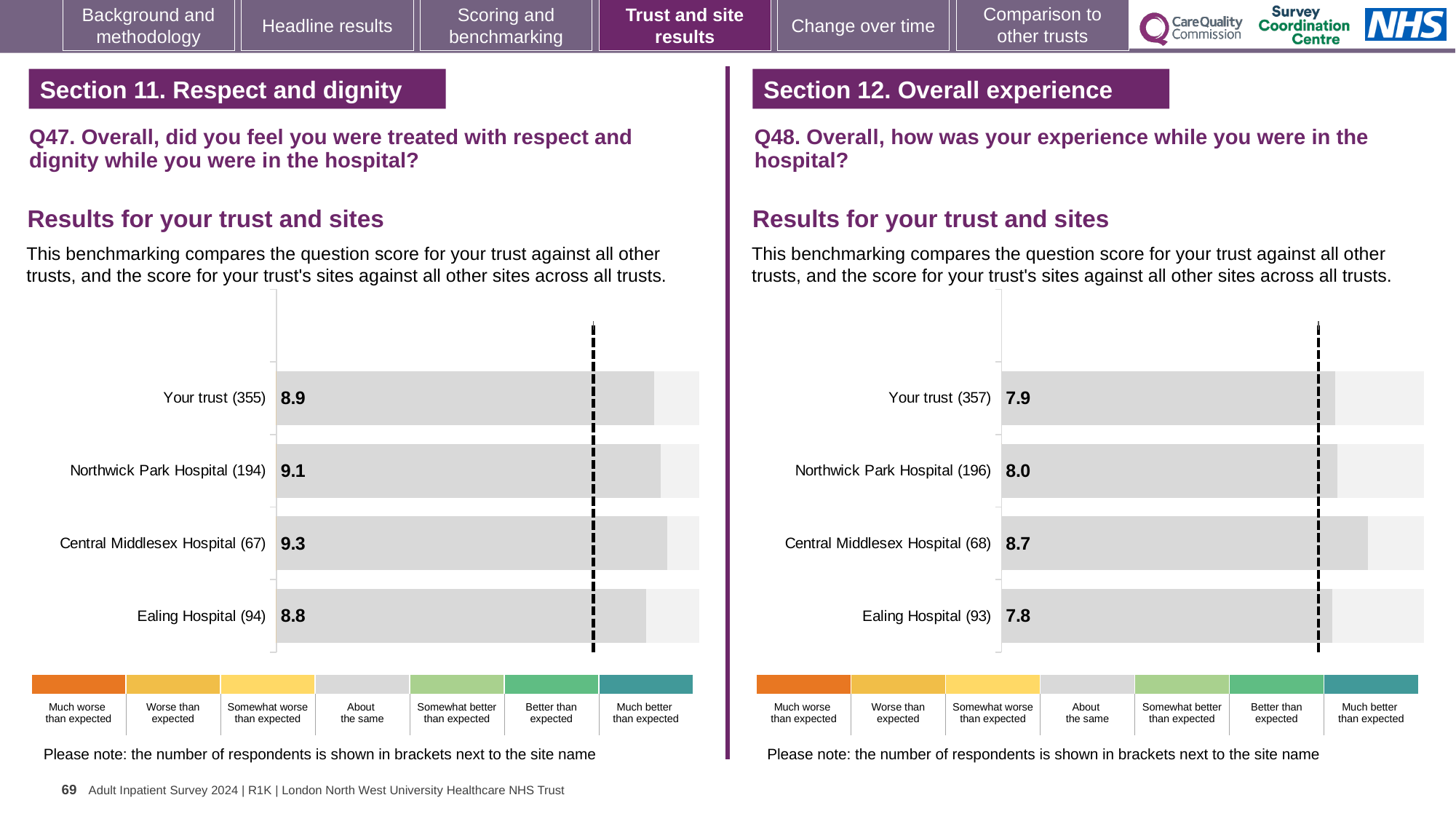
In the Q47 chart (left), what is the score for Your trust? 8.9 In the Q48 chart (right), which site or trust has the highest score? Central Middlesex Hospital In the Q48 chart (right), what is the difference between the scores for Central Middlesex Hospital and Your trust? 0.8 In the Q47 chart (left), what is the difference between the scores for Northwick Park Hospital and Ealing Hospital? 0.3 In the Q47 chart (left), what is the score for Central Middlesex Hospital? 9.3 What kind of chart is used for the Q48 results (right)? Bar chart How many bars are plotted in the Q47 chart (left)? 4 In the Q48 chart (right), which is larger, the score for Your trust or the score for Central Middlesex Hospital? Central Middlesex Hospital In the Q48 chart (right), what is the score for Northwick Park Hospital? 8.0 In the Q47 chart (left), which site or trust has the lowest score? Ealing Hospital In the Q47 chart (left), which site or trust has the highest score? Central Middlesex Hospital In the Q48 chart (right), what is the score for Ealing Hospital? 7.8